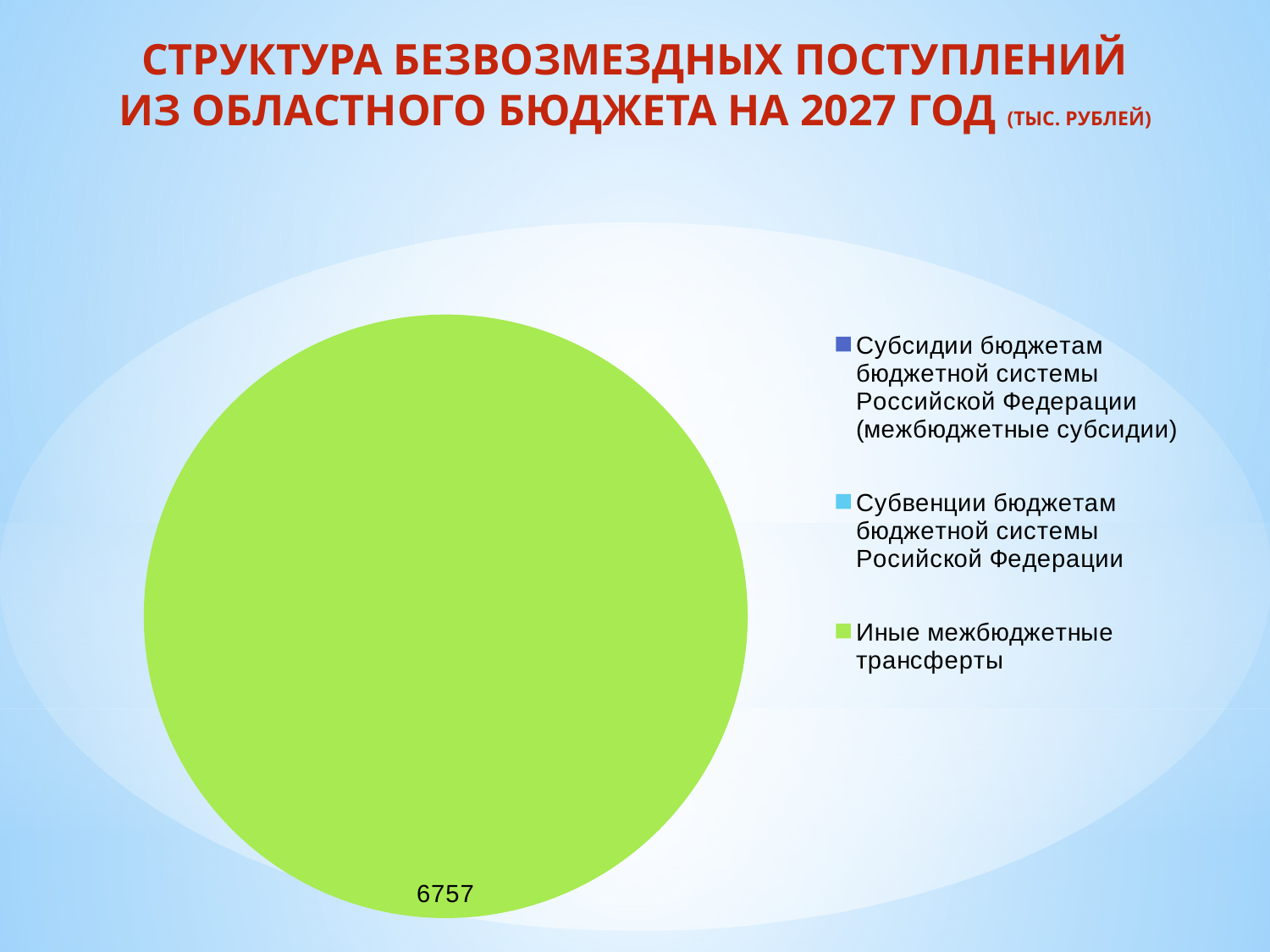
In what units are the values of the chart given, according to the slide title? тыс. рублей What colour is the slice for Иные межбюджетные трансферты? green How many data labels are printed on the pie chart? 1 Which category occupies the largest share of the pie chart? Иные межбюджетные трансферты What value is printed on the pie chart for Иные межбюджетные трансферты? 6757 What kind of chart is shown on the slide? pie chart Is the value for Иные межбюджетные трансферты greater or less than 5000? greater How many entries does the legend of the pie chart list? 3